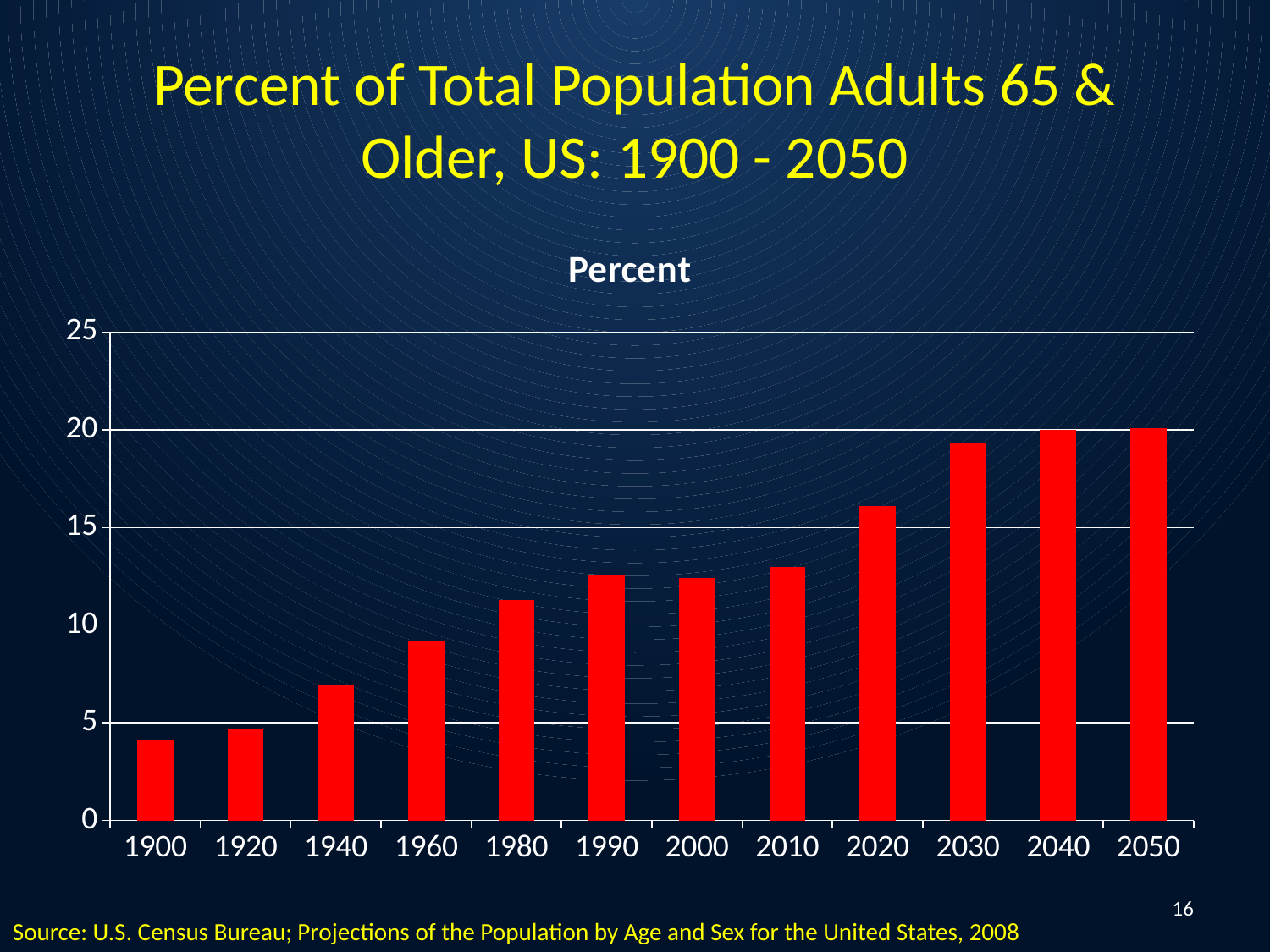
Which year has the lowest percent of adults 65 and older? 1900 Is the value for 1960 greater or less than 10? less Is the value for 1900 greater or less than 5? less Is the value for 1940 greater or less than 5? greater Do the values generally rise or fall from 1900 to 2050? rise How many years are shown along the x axis of the chart? 12 Which year has the larger value, 2010 or 2020? 2020 What kind of chart is shown on the slide? bar chart What colour are the bars in the chart? red